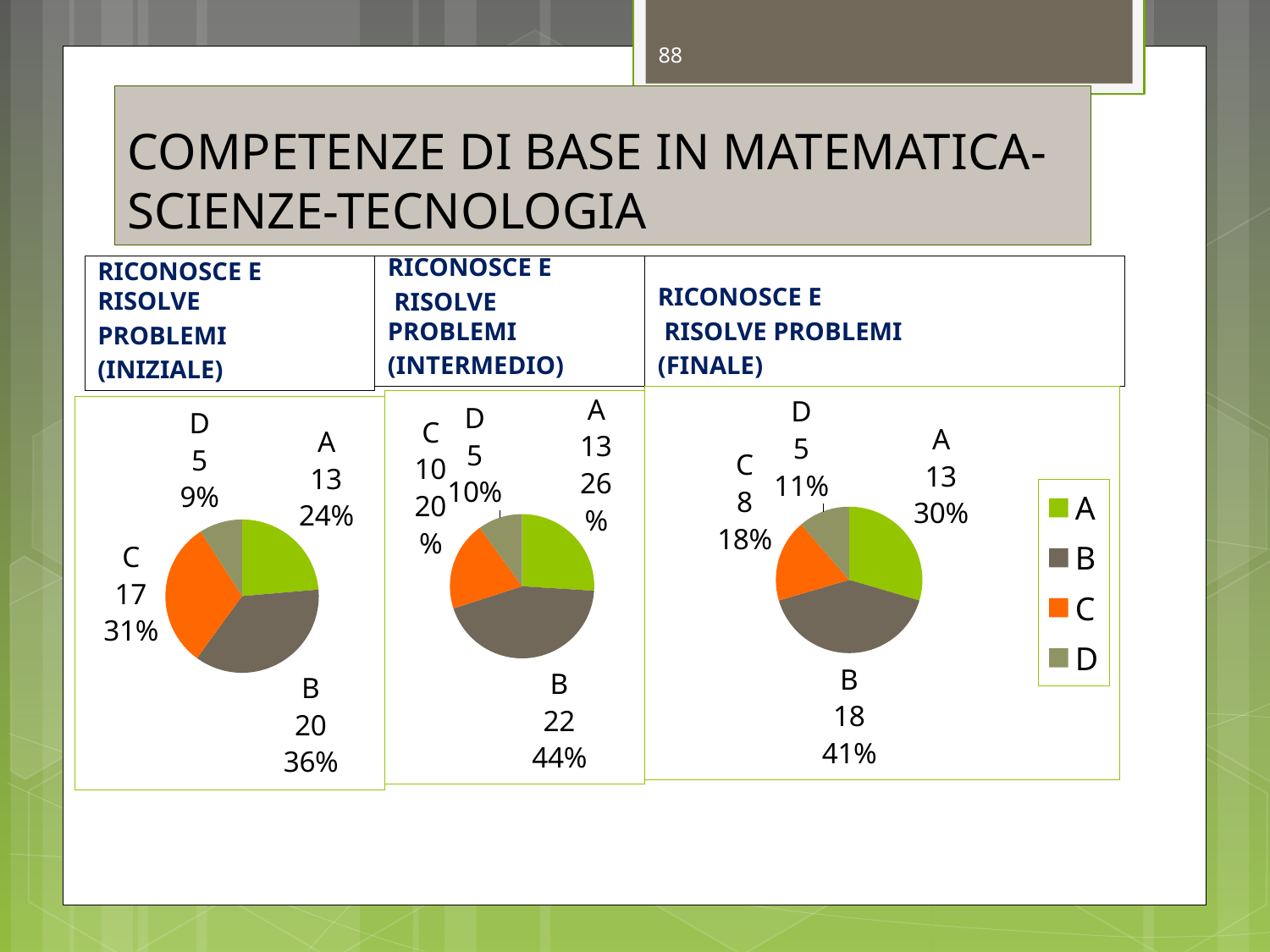
In the RICONOSCE E RISOLVE PROBLEMI (INIZIALE) pie chart, what percentage share does category C have? 31% In the RICONOSCE E RISOLVE PROBLEMI (INTERMEDIO) pie chart, what is the count for category C? 10 How many categories does the RICONOSCE E RISOLVE PROBLEMI (INTERMEDIO) pie chart show? 4 In the RICONOSCE E RISOLVE PROBLEMI (INIZIALE) pie chart, which is larger, the count for A or the count for C? C What type of chart is used for RICONOSCE E RISOLVE PROBLEMI (FINALE)? Pie chart In the RICONOSCE E RISOLVE PROBLEMI (INTERMEDIO) pie chart, which category has the largest slice? B In the RICONOSCE E RISOLVE PROBLEMI (INIZIALE) pie chart, what is the count for category B? 20 How many entries does the legend on the right of the slide list? 4 In the legend on the right of the slide, which colour represents category C? Orange In the RICONOSCE E RISOLVE PROBLEMI (FINALE) pie chart, what is the difference between the counts for B and C? 10 In the RICONOSCE E RISOLVE PROBLEMI (FINALE) pie chart, what percentage share does category A have? 30% In the RICONOSCE E RISOLVE PROBLEMI (FINALE) pie chart, which category has the smallest slice? D